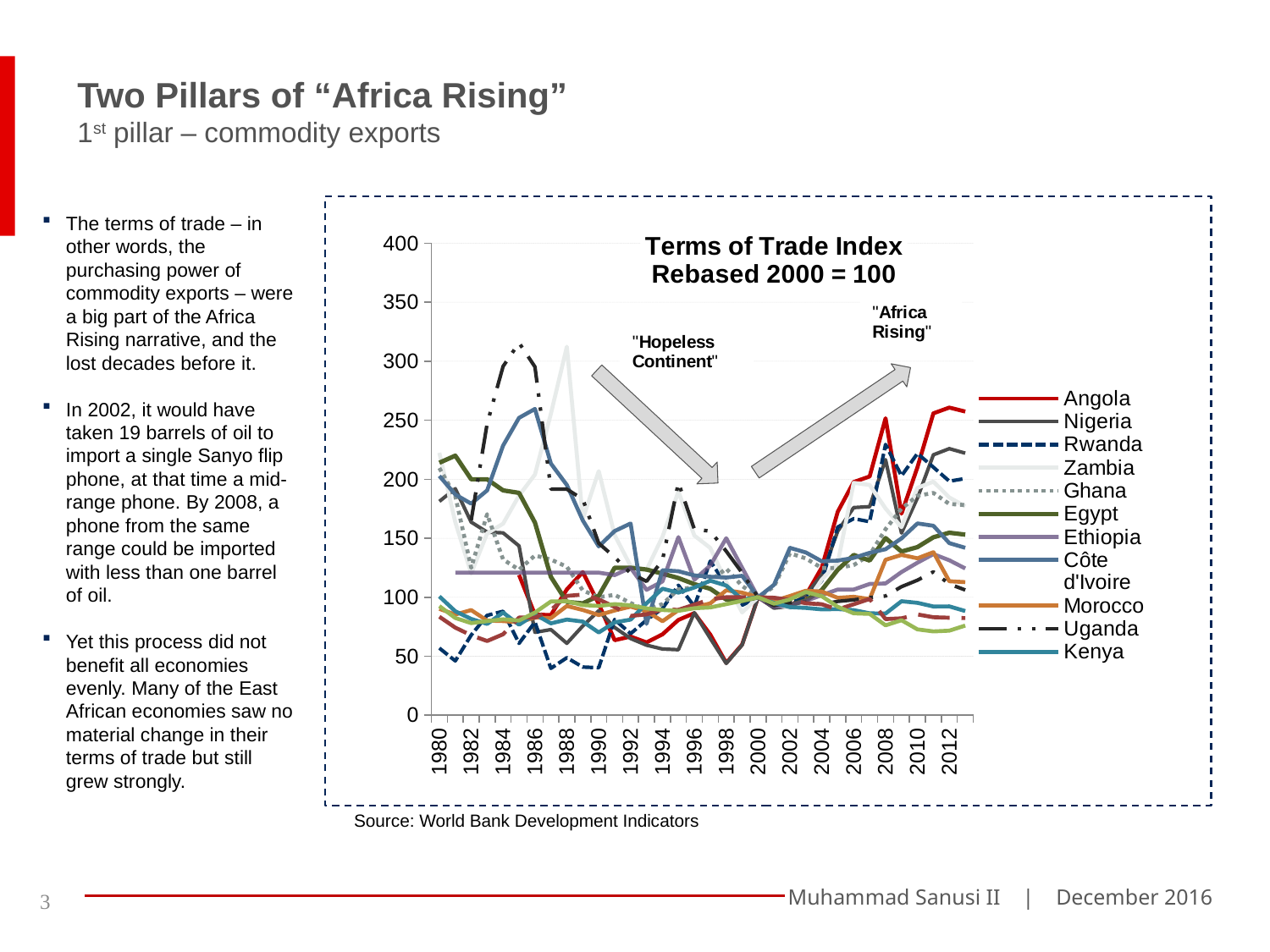
Is the value for Kenya in 2012 greater or less than 150? less Which series has the highest value in 2012? Angola Is the value for Uganda in 1985 greater or less than 250? greater What is the title of the chart? Terms of Trade Index Rebased 2000 = 100 Is the value for Rwanda in 1987 greater or less than 100? less Does the Angola series rise or fall between 2000 and 2008? rise What kind of chart is shown on the slide? Line chart Which series has the highest value in 1985? Uganda How many series does the chart's legend list? 11 Which is larger in 2012, the value for Angola or the value for Morocco? Angola Which series has the lowest value in 1987? Rwanda